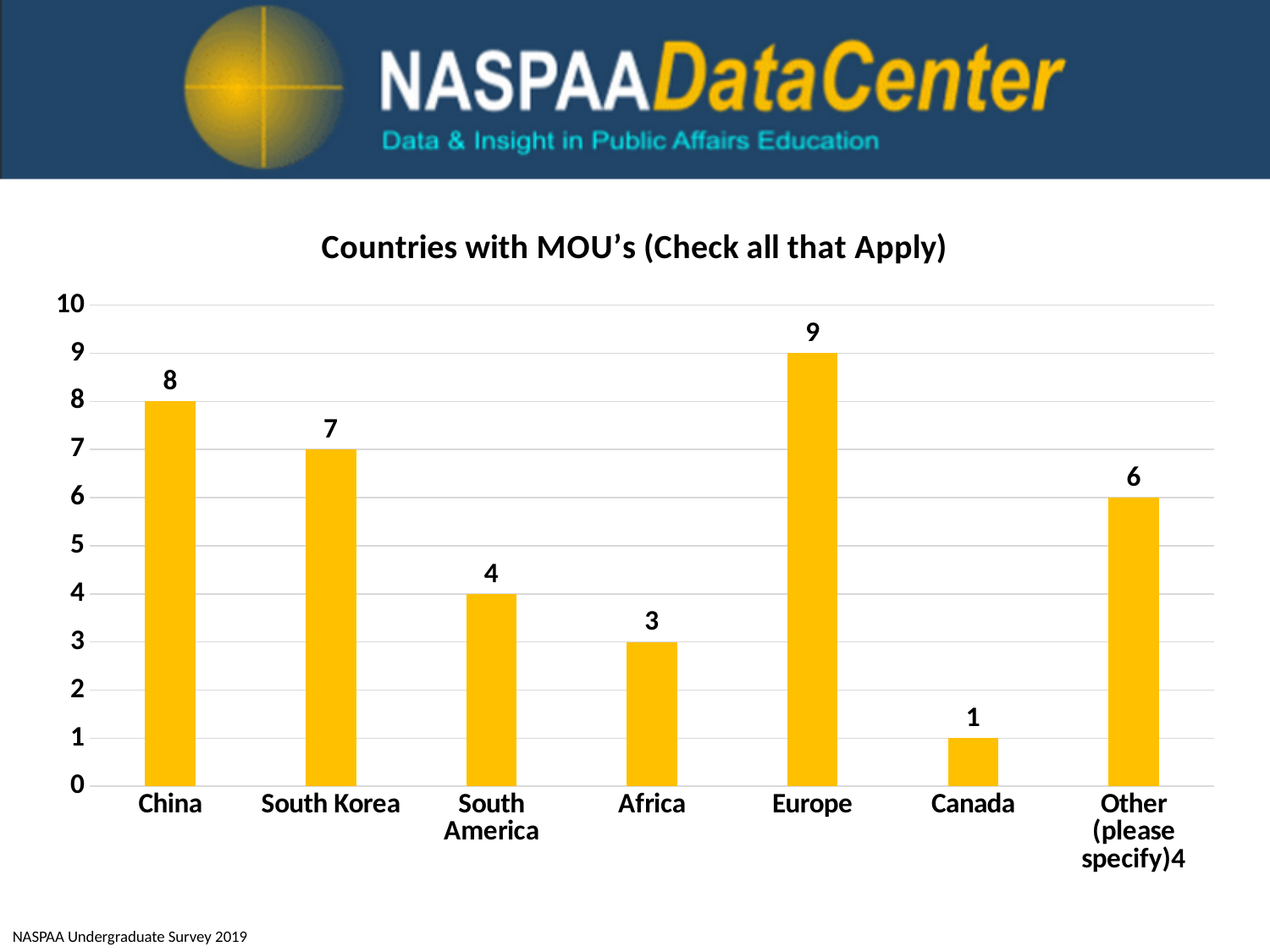
Which category has the highest value? Europe How many categories are shown on the x axis? 7 What is the difference between the values for China and South Korea? 1 What is the value for Europe? 9 What is the value for Canada? 1 What is the title of the chart? Countries with MOU's (Check all that Apply) What kind of chart is shown on the slide? Bar chart Which is larger, the value for South Korea or the value for Other (please specify)? South Korea What is the difference between the values for Europe and Africa? 6 What is the value for South America? 4 Which category has the lowest value? Canada What is the value for China? 8